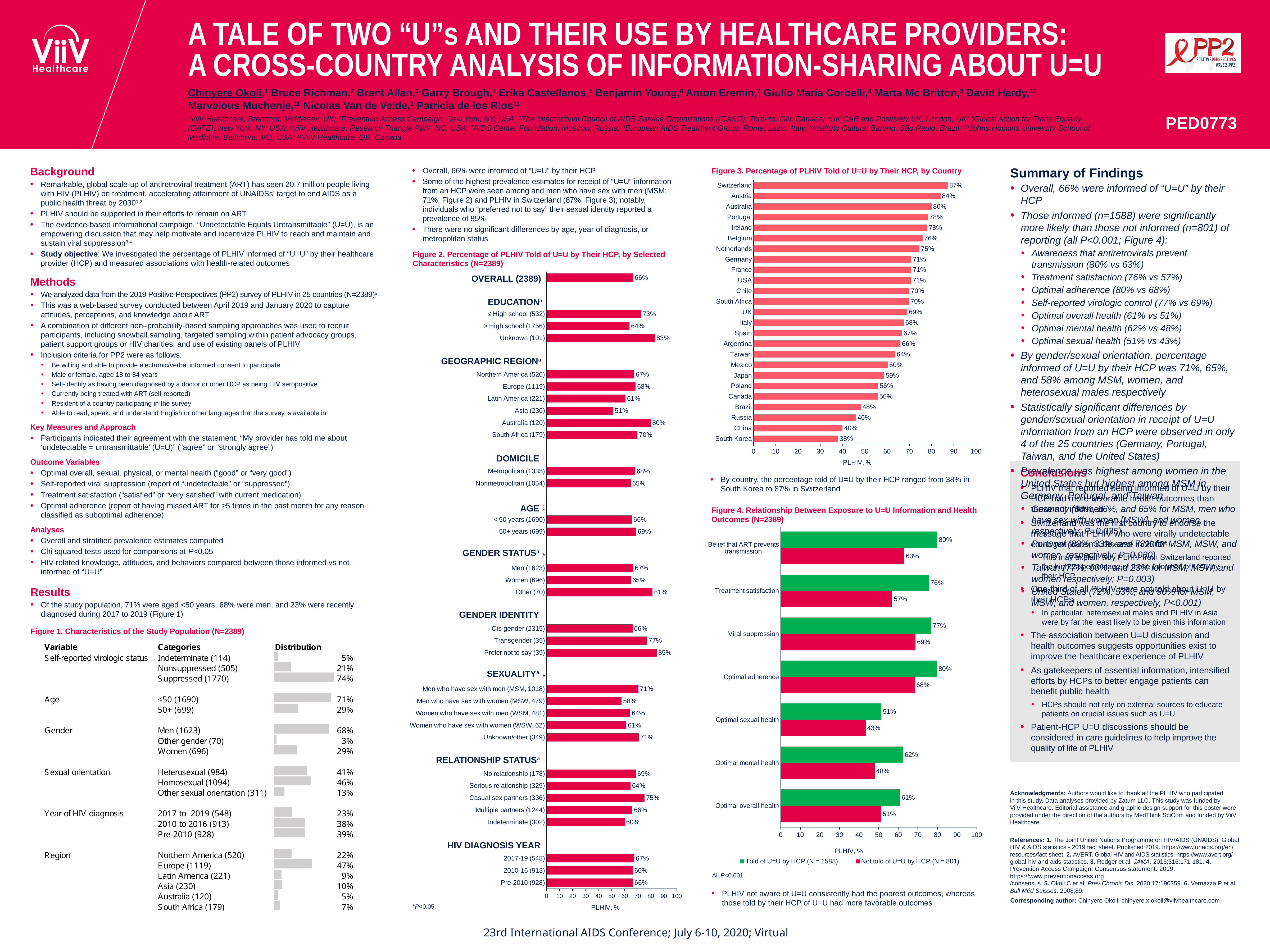
In Figure 3, which country has the highest percentage of PLHIV told of U=U by their HCP? Switzerland In Figure 4, what is the difference in treatment satisfaction between those told and those not told of U=U by HCP? 19% What kind of chart is Figure 3? Bar chart In Figure 4, what percentage of those told of U=U by HCP reported belief that ART prevents transmission? 80% In Figure 2, what is the percentage for Asia (230) under geographic region? 51% In Figure 4, how many series does the legend list? 2 In Figure 2, what is the percentage for 'Prefer not to say (39)' under gender identity? 85% In Figure 4, which group has the higher value for optimal sexual health: told of U=U by HCP or not told? Told of U=U by HCP In Figure 3, which country has the lowest percentage of PLHIV told of U=U by their HCP? South Korea In Figure 3, what is the difference between the values for Switzerland and South Korea? 49% In Figure 3, what is the percentage for Portugal? 78% In Figure 3, how many countries are plotted? 25